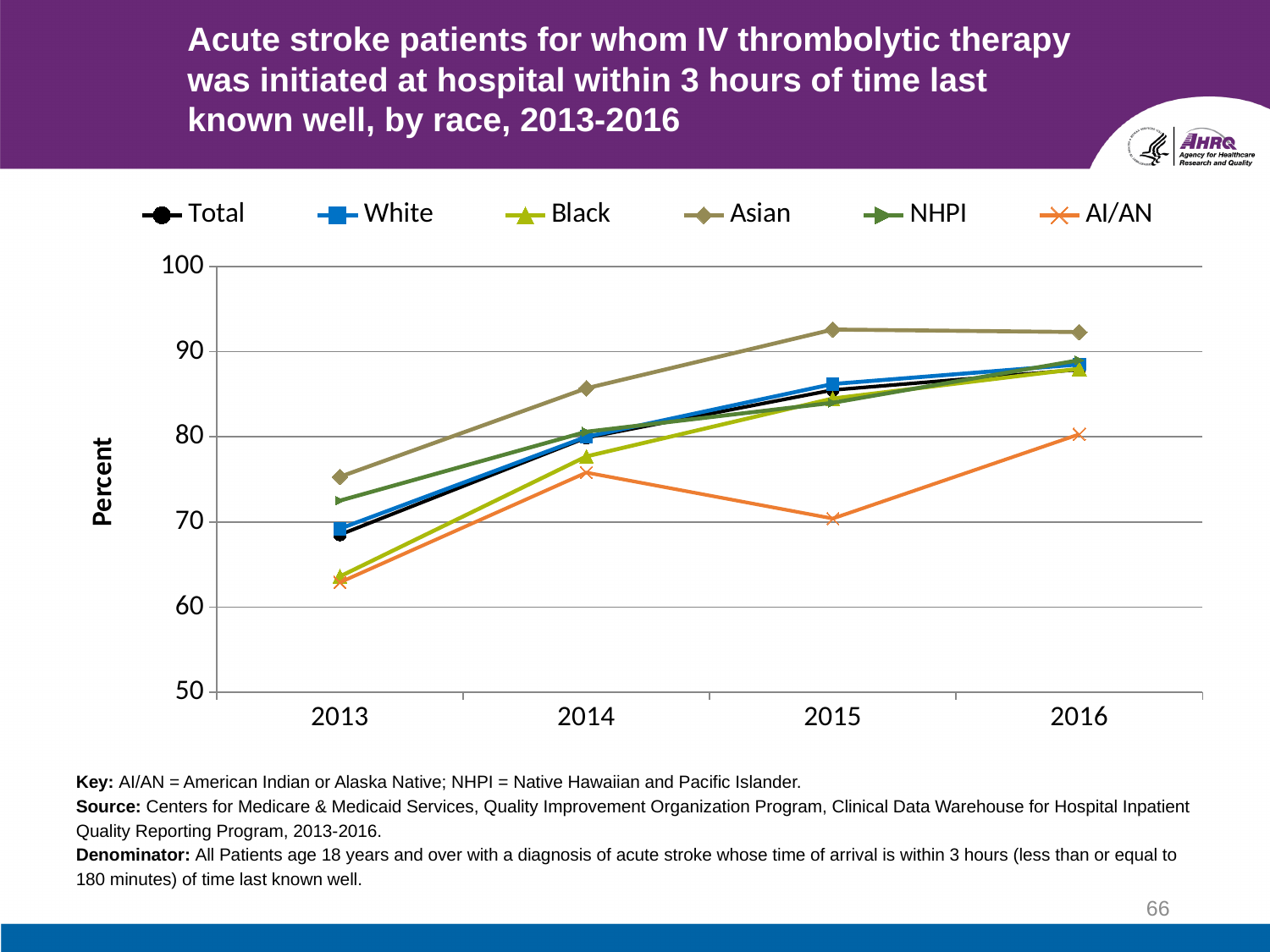
What is the label on the y axis? Percent How many years are plotted along the x axis? 4 Is the value for Asian in 2015 greater or less than 90? greater Which group had the lowest value in 2016? AI/AN What kind of chart is shown on the slide? Line chart Does the AI/AN line rise or fall from 2014 to 2015? Fall Is the value for Black in 2013 greater or less than 70? less Is the value for AI/AN in 2015 greater or less than 80? less Which group had the lowest value in 2015? AI/AN In 2014, which is larger, the value for Asian or the value for AI/AN? Asian Which group had the highest value in 2015? Asian How many series does the legend list? 6